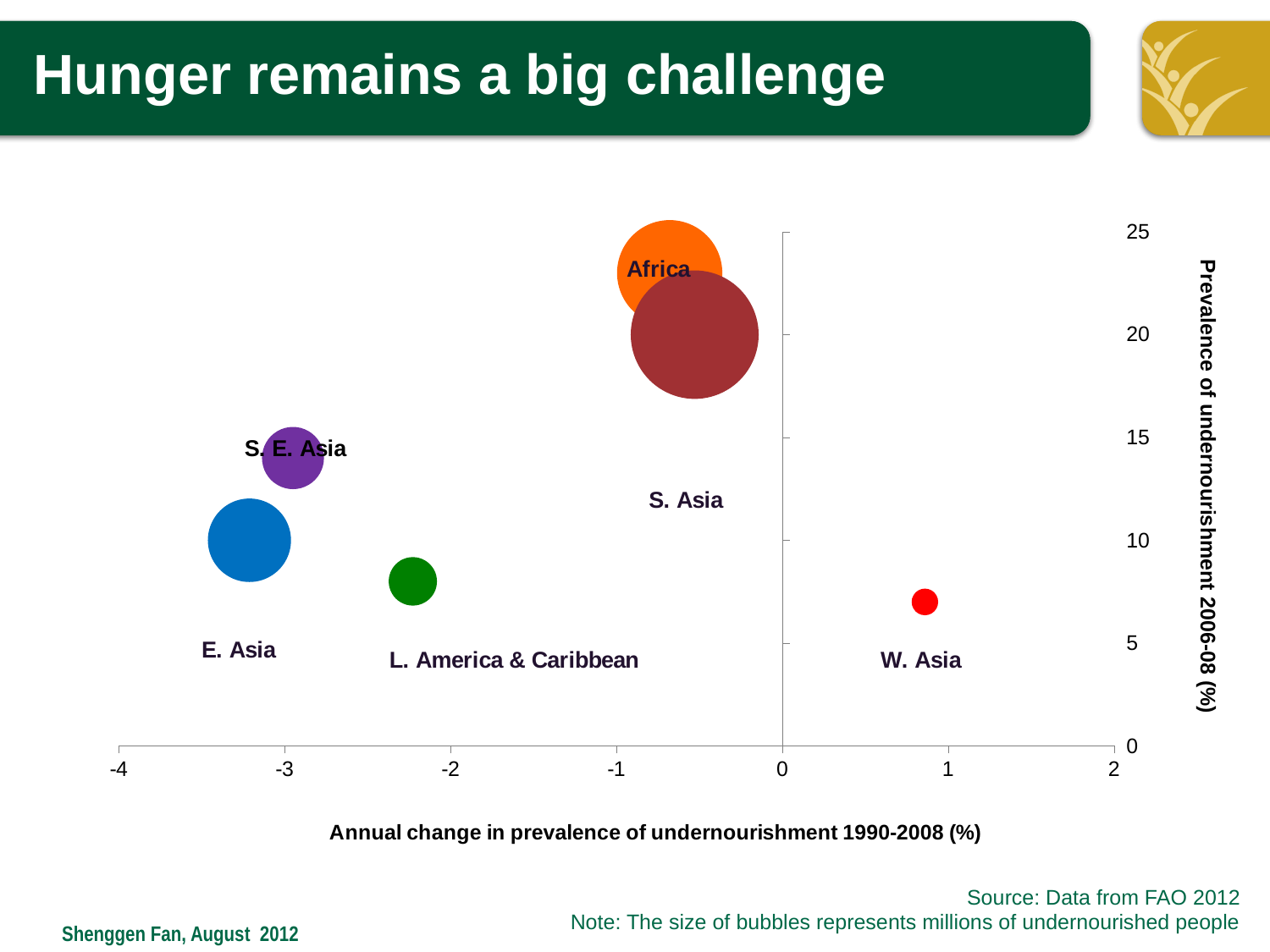
Is the prevalence of undernourishment for W. Asia greater or less than 10? less Is the annual change in prevalence of undernourishment for E. Asia greater or less than -2? less Which region has the lowest prevalence of undernourishment 2006-08? W. Asia Which region has the largest bubble, i.e. the most millions of undernourished people? S. Asia Is the annual change in prevalence of undernourishment for W. Asia greater or less than 0? greater Which has a higher prevalence of undernourishment, S. Asia or E. Asia? S. Asia What kind of chart is shown on the slide? Bubble chart According to the note, what does the size of the bubbles represent? Millions of undernourished people Which region has the highest prevalence of undernourishment 2006-08? Africa How many regions are plotted as bubbles on the chart? 6